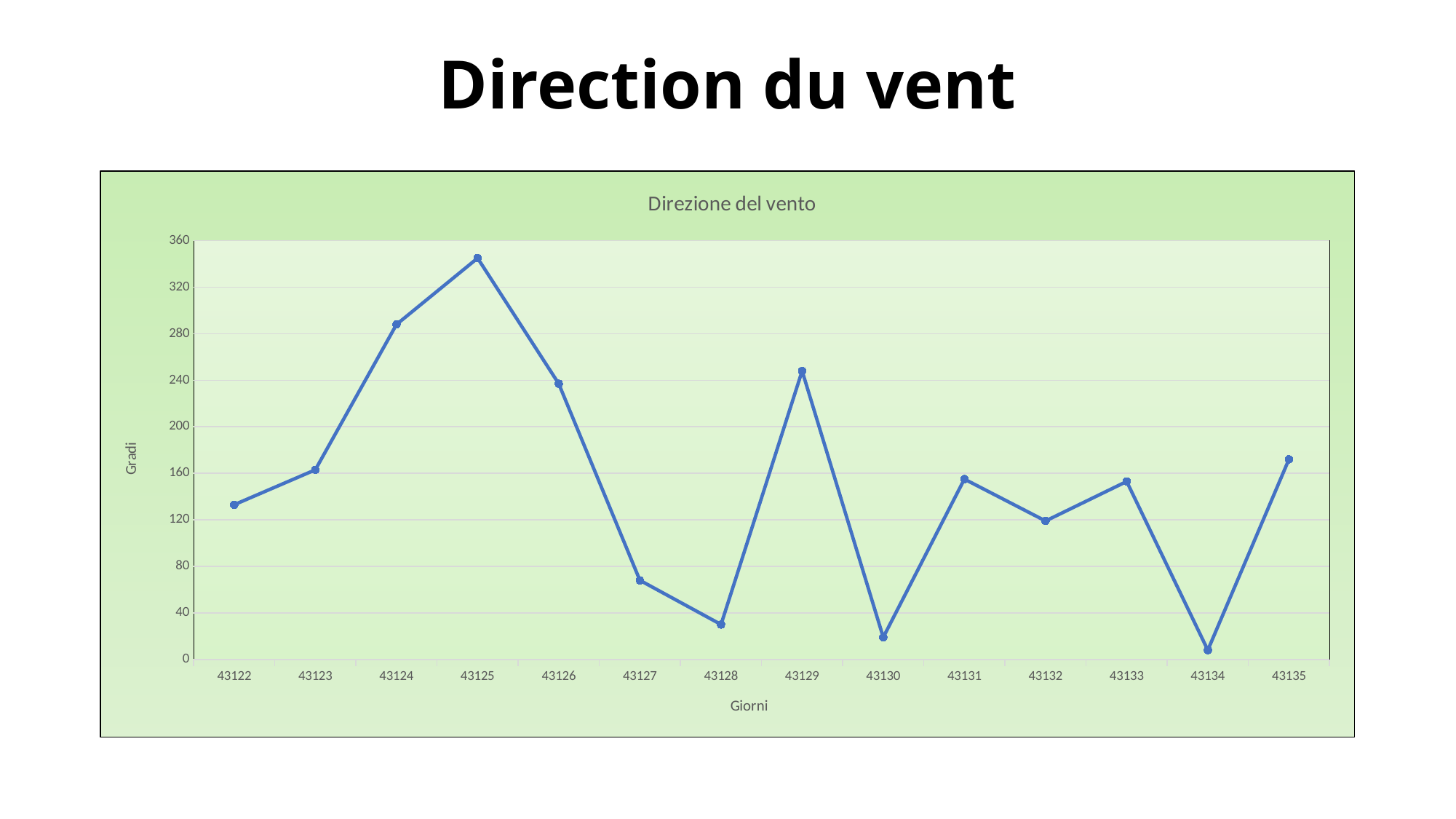
Which day has the lowest wind direction value? 43134 What kind of chart is shown on the slide? line chart Is the value for 43127 greater or less than 80? less Is the value for 43128 greater or less than 40? less Is the value for 43125 greater or less than 320? greater Which day has the highest wind direction value? 43125 What is the title of the chart? Direzione del vento Which is larger, the value for 43124 or the value for 43126? 43124 How many data points are plotted on the line? 14 What is the label of the vertical axis? Gradi Do the values rise or fall from 43122 to 43125? rise